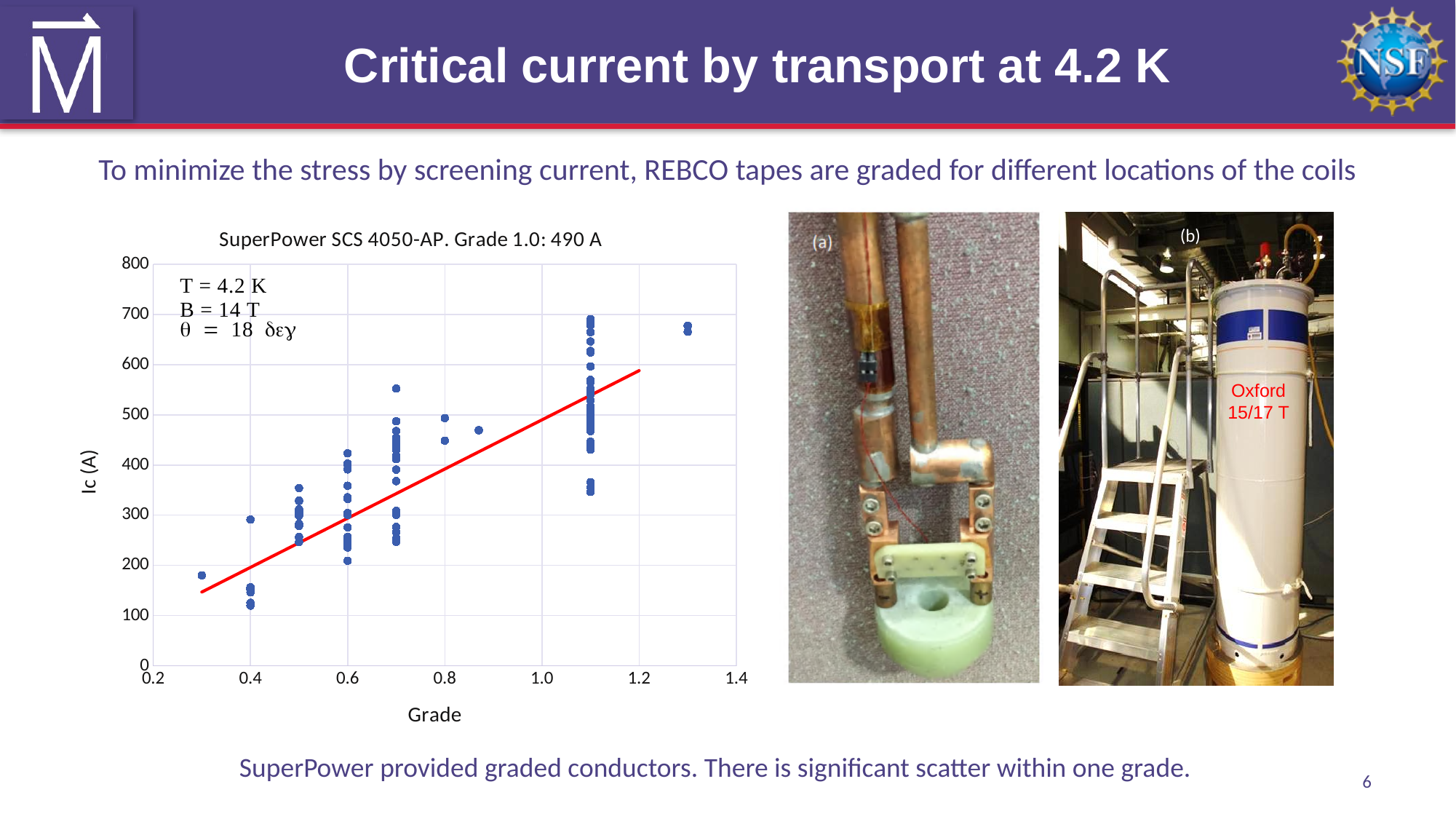
Is the lowest Ic value for the points at Grade 1.1 greater or less than 300? greater Which has the larger Ic value: the point at Grade 0.3 or the point at Grade 0.87? Grade 0.87 Is the Ic value for the point at Grade 0.87 greater or less than 400? greater At which Grade does the lowest Ic point on the chart occur? 0.4 Do the Ic values generally rise or fall as Grade increases along the x axis? Rise What is the title of the chart? SuperPower SCS 4050-AP. Grade 1.0: 490 A Is the Ic value for the point at Grade 0.3 greater or less than 200? less What kind of chart is shown on the slide? Scatter chart What is the label of the y axis of the chart? Ic (A)